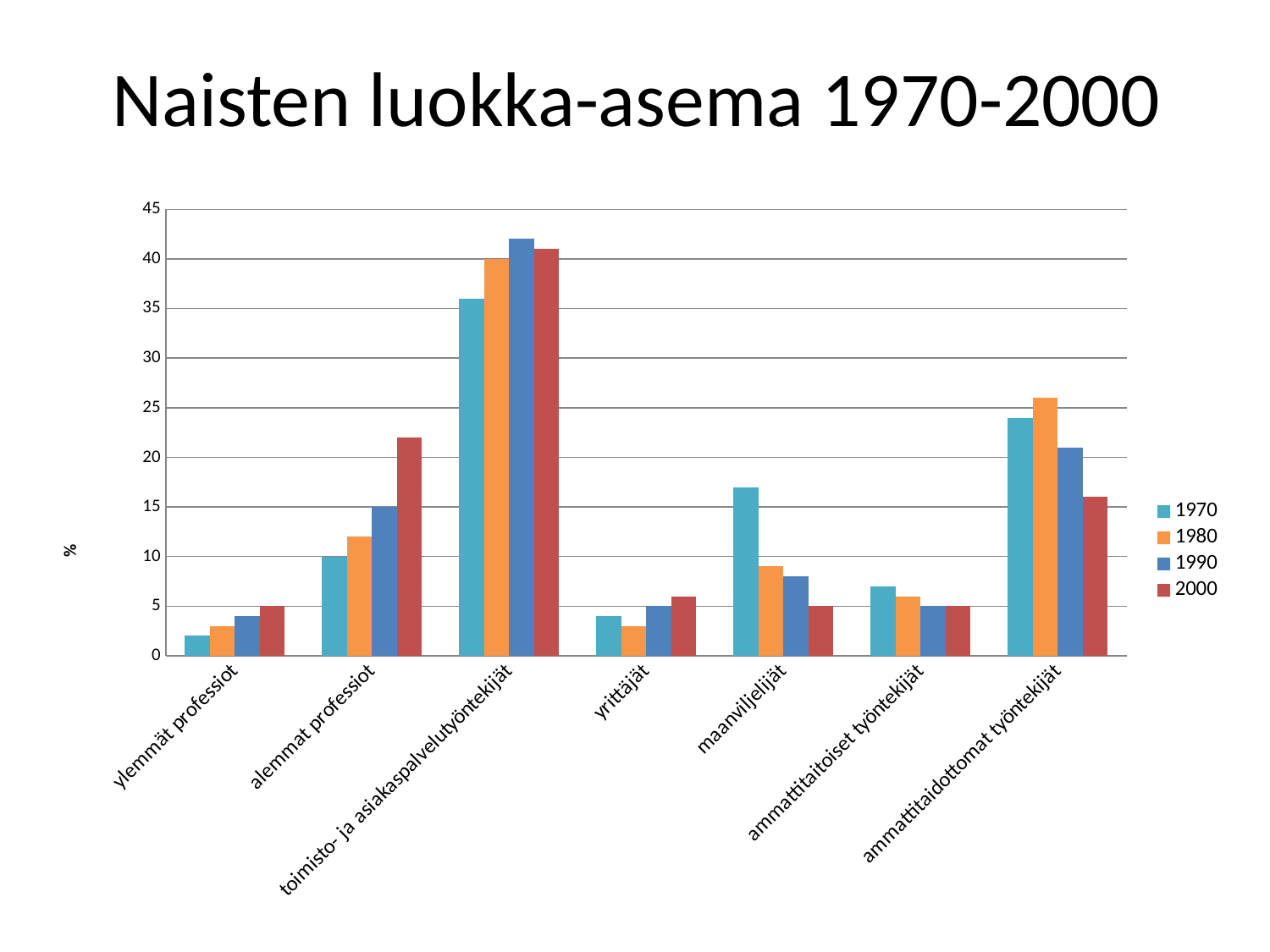
What is the label on the y axis? % Do the values for maanviljelijät rise or fall from 1970 to 2000? fall Is the value for maanviljelijät in 1970 greater or less than 15? greater Which category has the lowest value for 1970? ylemmät professiot Is the value for toimisto- ja asiakaspalvelutyöntekijät in 1990 greater or less than 40? greater Which category has the highest value for 1990? toimisto- ja asiakaspalvelutyöntekijät How many series does the legend list? 4 Do the values for alemmat professiot rise or fall from 1970 to 2000? rise What is the value for alemmat professiot in 1970? 10 What kind of chart is shown on the slide? bar chart For ammattitaidottomat työntekijät, which year has the larger value, 1980 or 2000? 1980 How many categories are shown on the x axis? 7